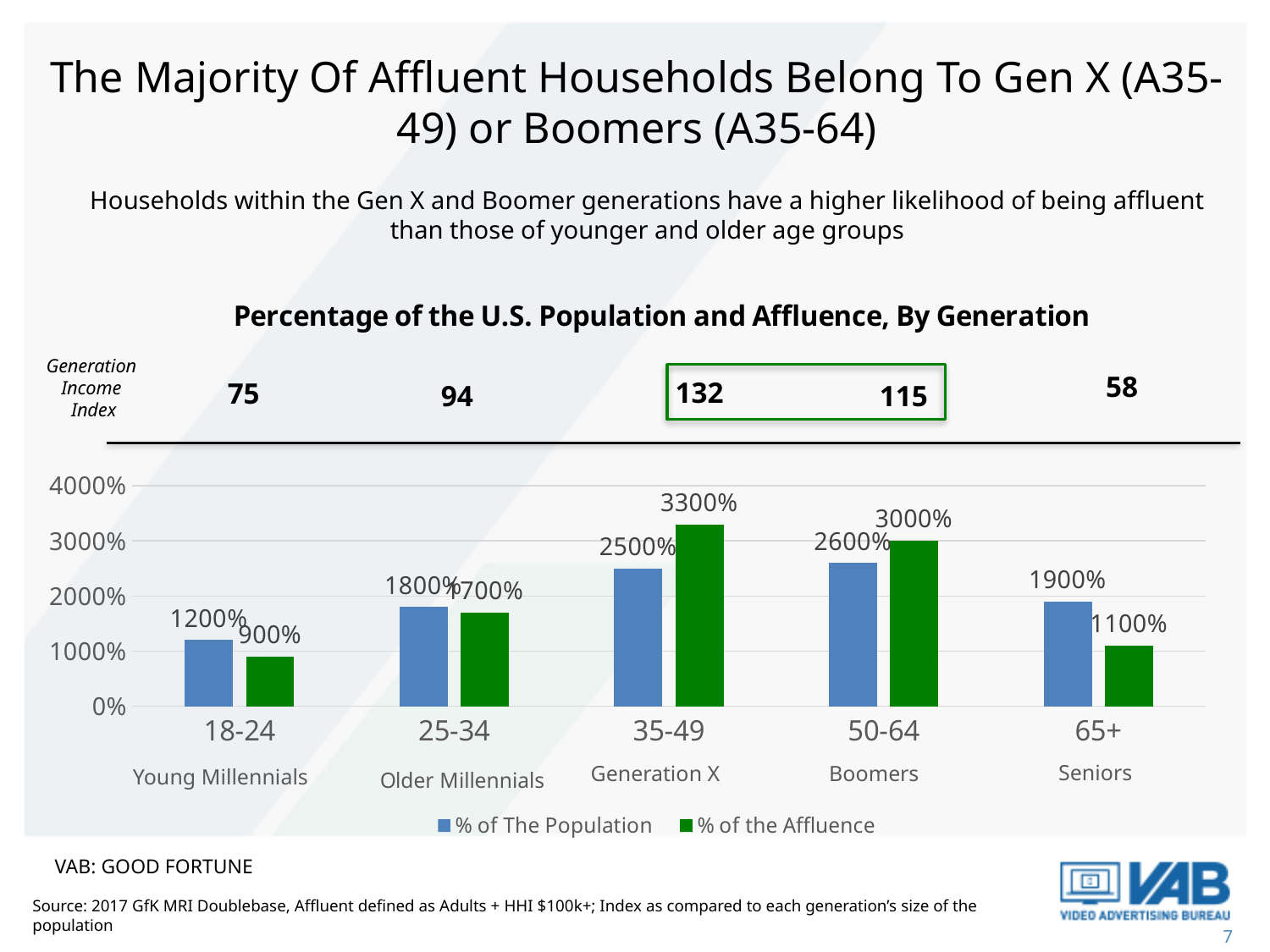
What is the value of % of the Affluence for the 65+ (Seniors) group? 1100% What is the difference between % of the Affluence and % of The Population for the 35-49 group? 800% What is the title of the chart? Percentage of the U.S. Population and Affluence, By Generation For the 65+ group, which is larger: % of The Population or % of the Affluence? % of The Population What is the value of % of the Affluence for the 35-49 (Generation X) group? 3300% What is the value of % of The Population for the 50-64 (Boomers) group? 2600% Which age group has the lowest % of The Population? 18-24 (Young Millennials) Is the % of the Affluence value for the 50-64 group greater or less than 2000%? greater How many age groups are shown on the x axis of the chart? 5 How many series does the chart legend list? 2 Which age group has the highest % of the Affluence? 35-49 (Generation X) What kind of chart is shown on the slide? Bar chart